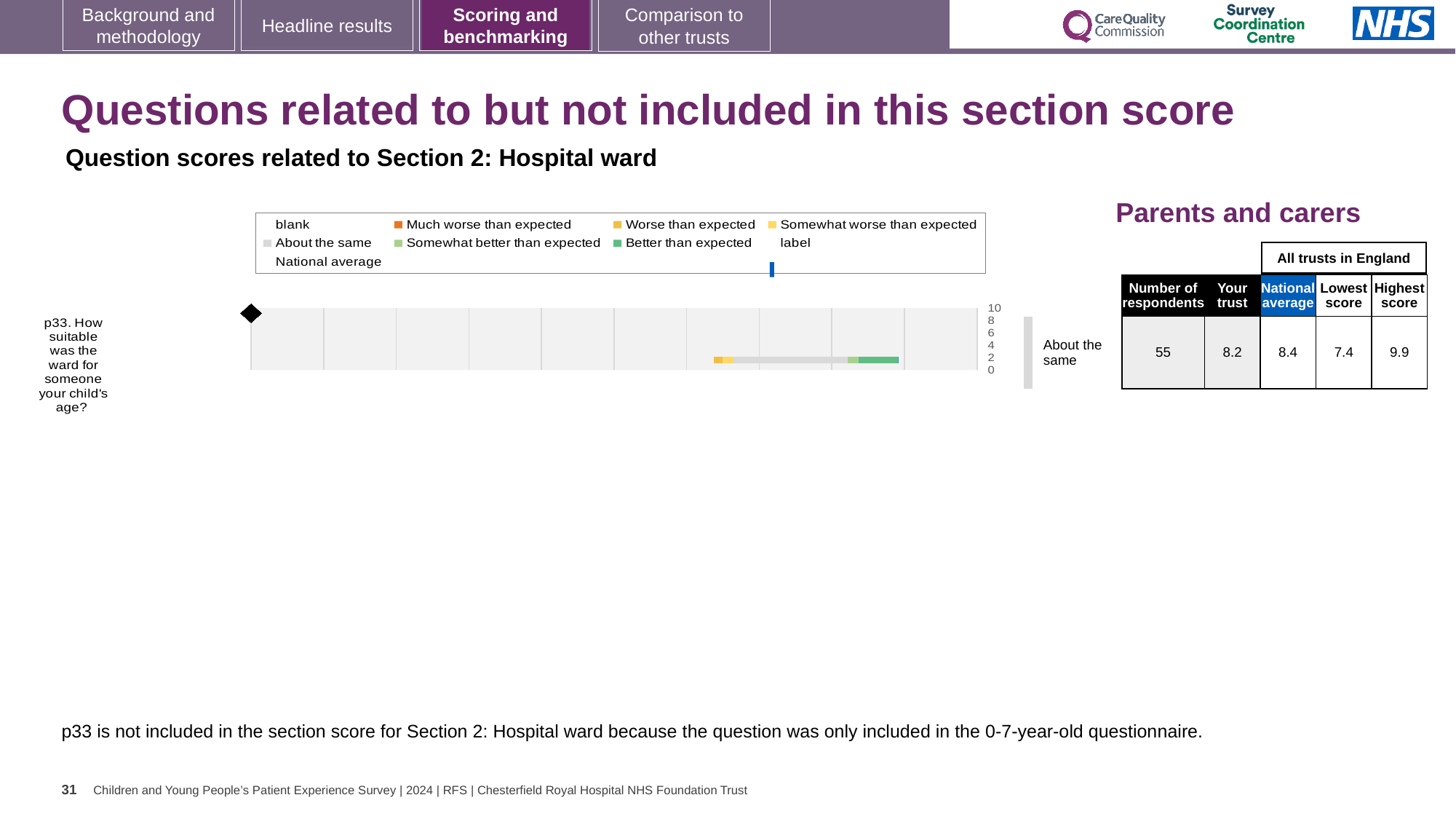
What is the 'Your trust' score for p33 in the Parents and carers table? 8.2 What is the difference between the Highest score and the Lowest score for p33? 2.5 What is the Highest score among all trusts in England for p33? 9.9 How many respondents answered p33? 55 What benchmark category label is shown to the right of the p33 bar? About the same What is the Lowest score among all trusts in England for p33? 7.4 Which is higher for p33: the Your trust score or the National average? National average Which question is plotted in the chart? p33. How suitable was the ward for someone your child's age? What type of chart is used to show the p33 question score? bar chart By how much does the National average exceed the Your trust score for p33? 0.2 What is the National average score for p33? 8.4 How many questions are plotted in the chart? 1